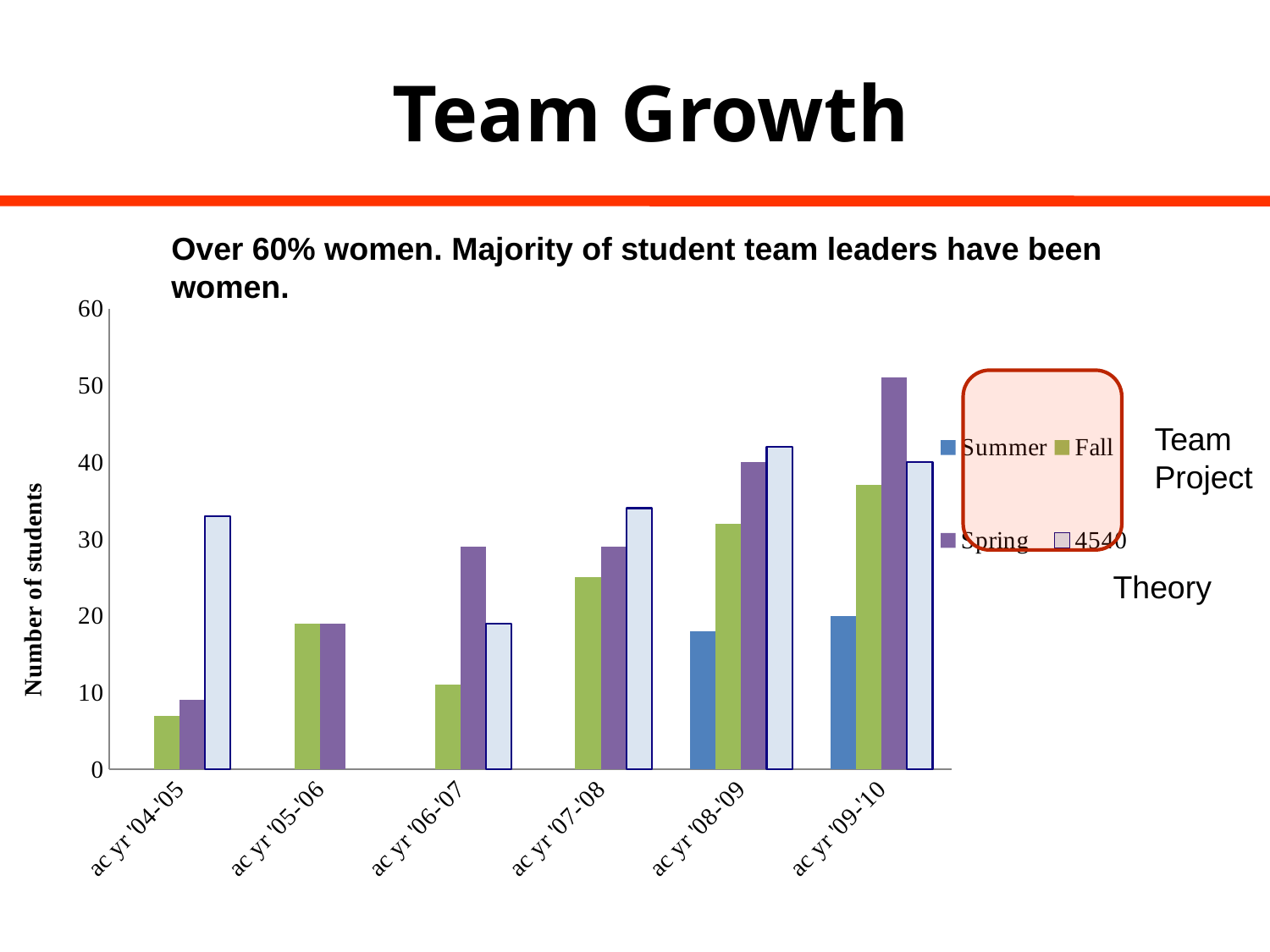
Is the value for Fall in ac yr '04-'05 greater or less than 10? less Is the value for 4540 in ac yr '04-'05 greater or less than 30? greater How many academic-year categories are shown on the x axis? 6 In ac yr '06-'07, which is larger, the Spring bar or the 4540 bar? Spring In which academic year is the Fall bar the lowest? ac yr '04-'05 What is the title of the y axis? Number of students Which series has the tallest bar in the whole chart? Spring Is the value for Spring in ac yr '09-'10 greater or less than 40? greater Do the Fall values rise or fall from ac yr '05-'06 to ac yr '09-'10? rise What kind of chart is shown on the slide? bar chart How many series does the legend list? 4